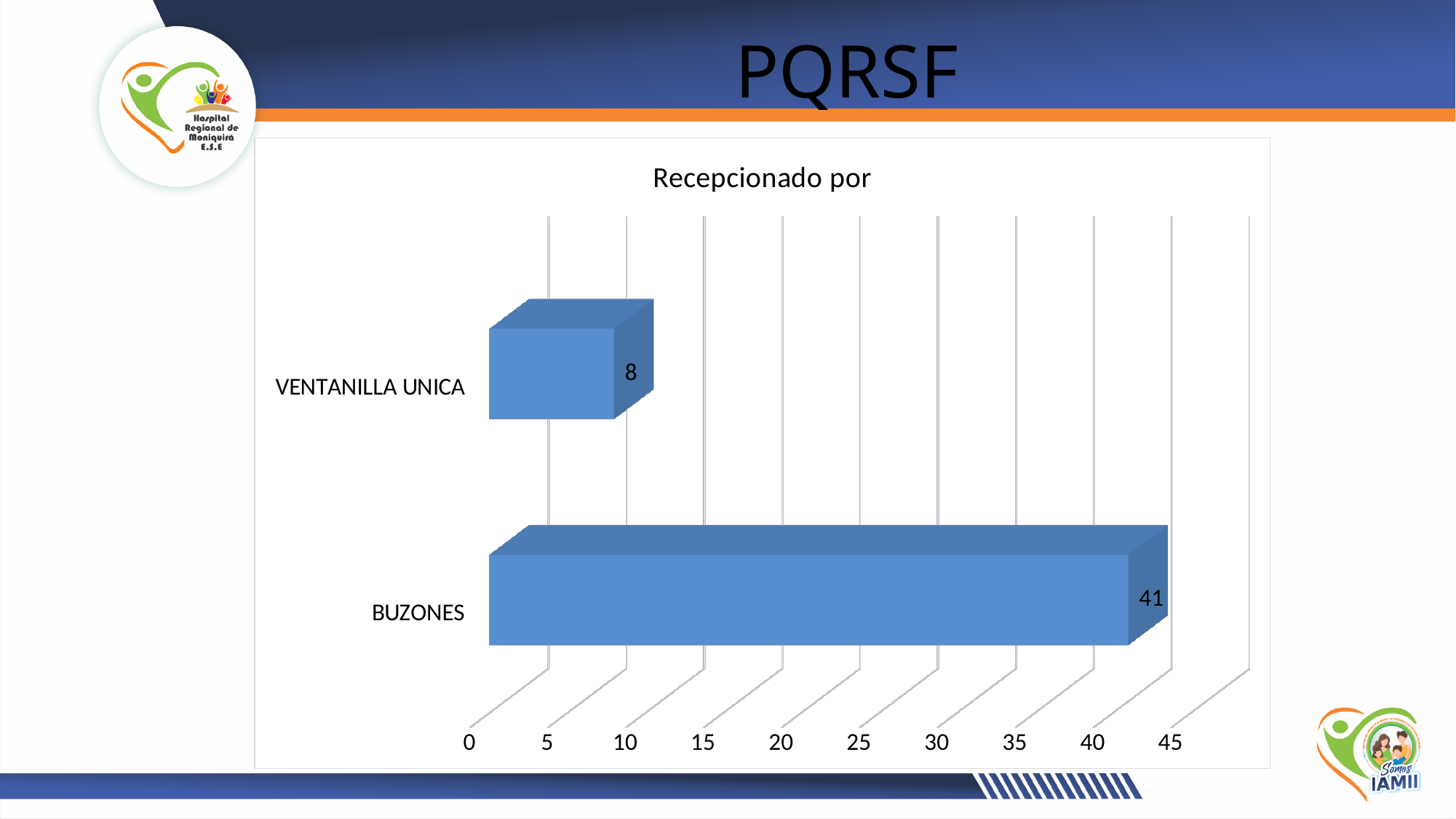
Which category has the lowest value? VENTANILLA UNICA What kind of chart is shown on the slide? Bar chart Which is larger, the value for BUZONES or the value for VENTANILLA UNICA? BUZONES Which category has the highest value? BUZONES What is the difference between the values for BUZONES and VENTANILLA UNICA? 33 Is the value for BUZONES greater or less than 40? greater What is the value for BUZONES? 41 What is the title of the chart? Recepcionado por What is the highest value shown on the value axis? 45 Is the value for VENTANILLA UNICA greater or less than 10? less How many categories are shown in the chart? 2 What is the value for VENTANILLA UNICA? 8